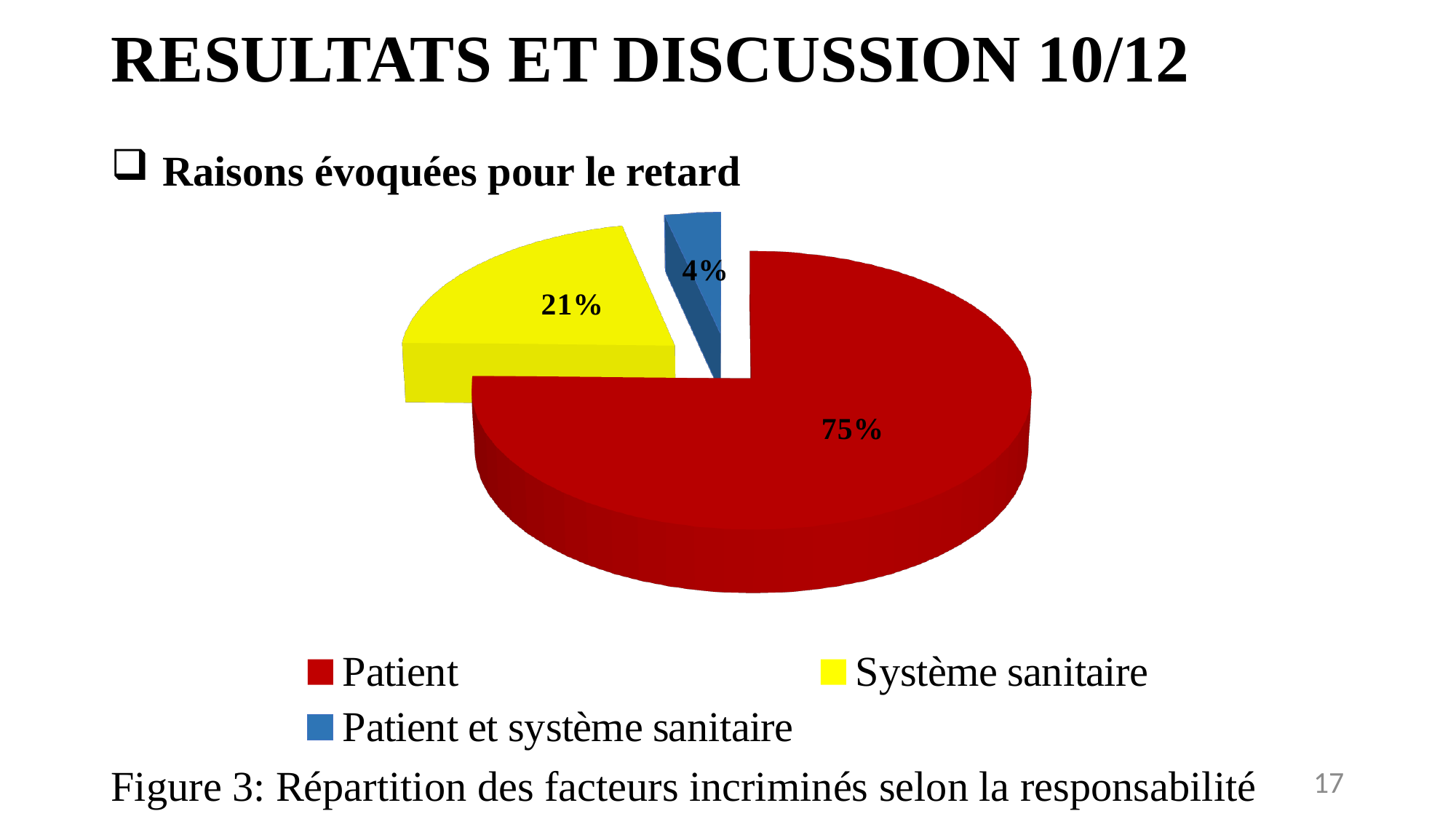
What share of the pie does Patient account for? 75% What share of the pie does Système sanitaire account for? 21% Which is larger, the Système sanitaire slice or the Patient et système sanitaire slice? Système sanitaire Which category has the smallest slice of the pie? Patient et système sanitaire What is the caption of the figure below the chart? Figure 3: Répartition des facteurs incriminés selon la responsabilité What share of the pie does Patient et système sanitaire account for? 4% How many categories does the pie chart show? 3 What is the difference in percentage points between the Patient slice and the Système sanitaire slice? 54 What is the difference in percentage points between the Système sanitaire slice and the Patient et système sanitaire slice? 17 Which category has the largest slice of the pie? Patient What colour is the Système sanitaire slice? Yellow What kind of chart is shown on the slide? Pie chart